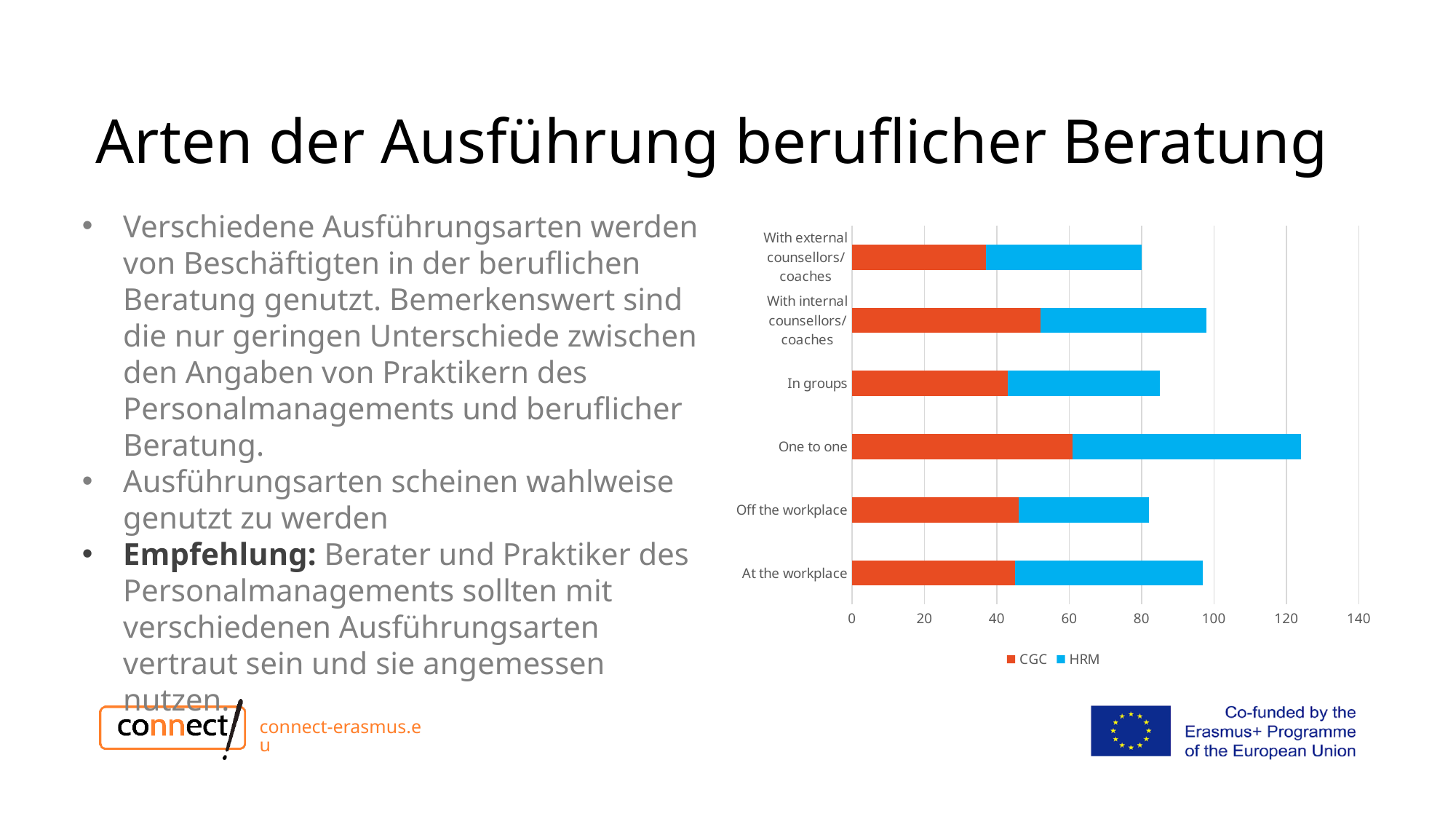
Which colour represents the HRM series in the chart? blue Is the total bar for At the workplace greater or less than 80? greater How many categories are shown on the chart's vertical axis? 6 Is the CGC value for One to one greater or less than 40? greater Which two series are listed in the chart legend? CGC and HRM Which category has the longest total bar? One to one Is the total bar for One to one greater or less than 100? greater Which has the longer total bar, One to one or In groups? One to one Which category has the largest CGC segment? One to one How many series does the chart legend list? 2 What kind of chart is shown on the slide? stacked bar chart